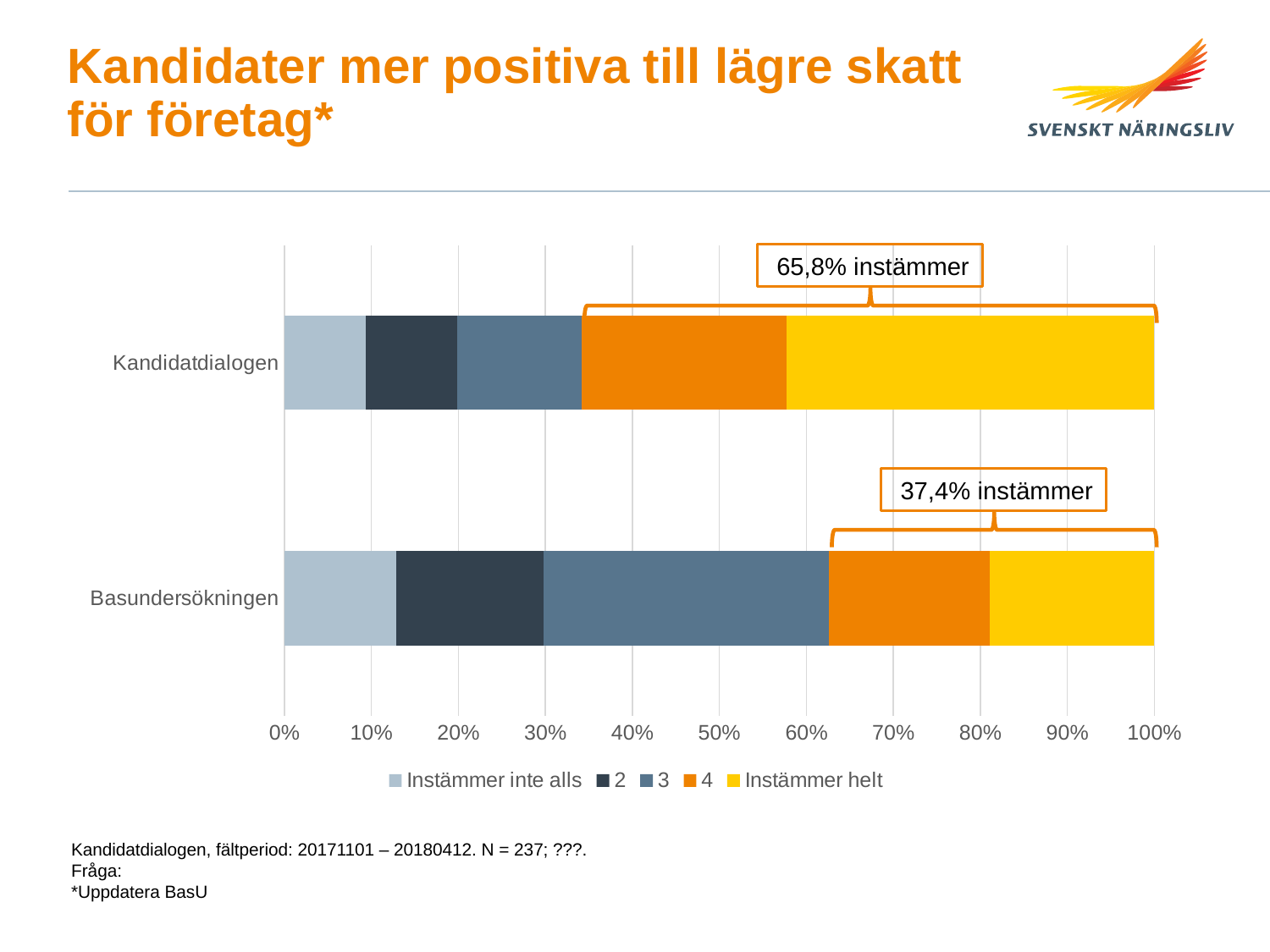
What combined share of Basundersökningen respondents agree (instämmer), according to the annotation? 37,4% Is the 'Instämmer helt' segment for Basundersökningen greater or less than 30%? less What combined share of Kandidatdialogen respondents agree (instämmer), according to the annotation? 65,8% How many categories are plotted on the chart? 2 What is the first entry in the chart's legend? Instämmer inte alls What kind of chart is shown on the slide? Stacked bar chart Which category has the higher share of respondents who agree (instämmer), Kandidatdialogen or Basundersökningen? Kandidatdialogen What is the difference between the agreeing share for Kandidatdialogen (65,8%) and for Basundersökningen (37,4%)? 28,4 percentage points How many series does the legend list? 5 What is the title of the slide? Kandidater mer positiva till lägre skatt för företag* Is the 'Instämmer helt' segment for Kandidatdialogen greater or less than 30%? greater Is the 'Instämmer inte alls' segment for Kandidatdialogen greater or less than 20%? less